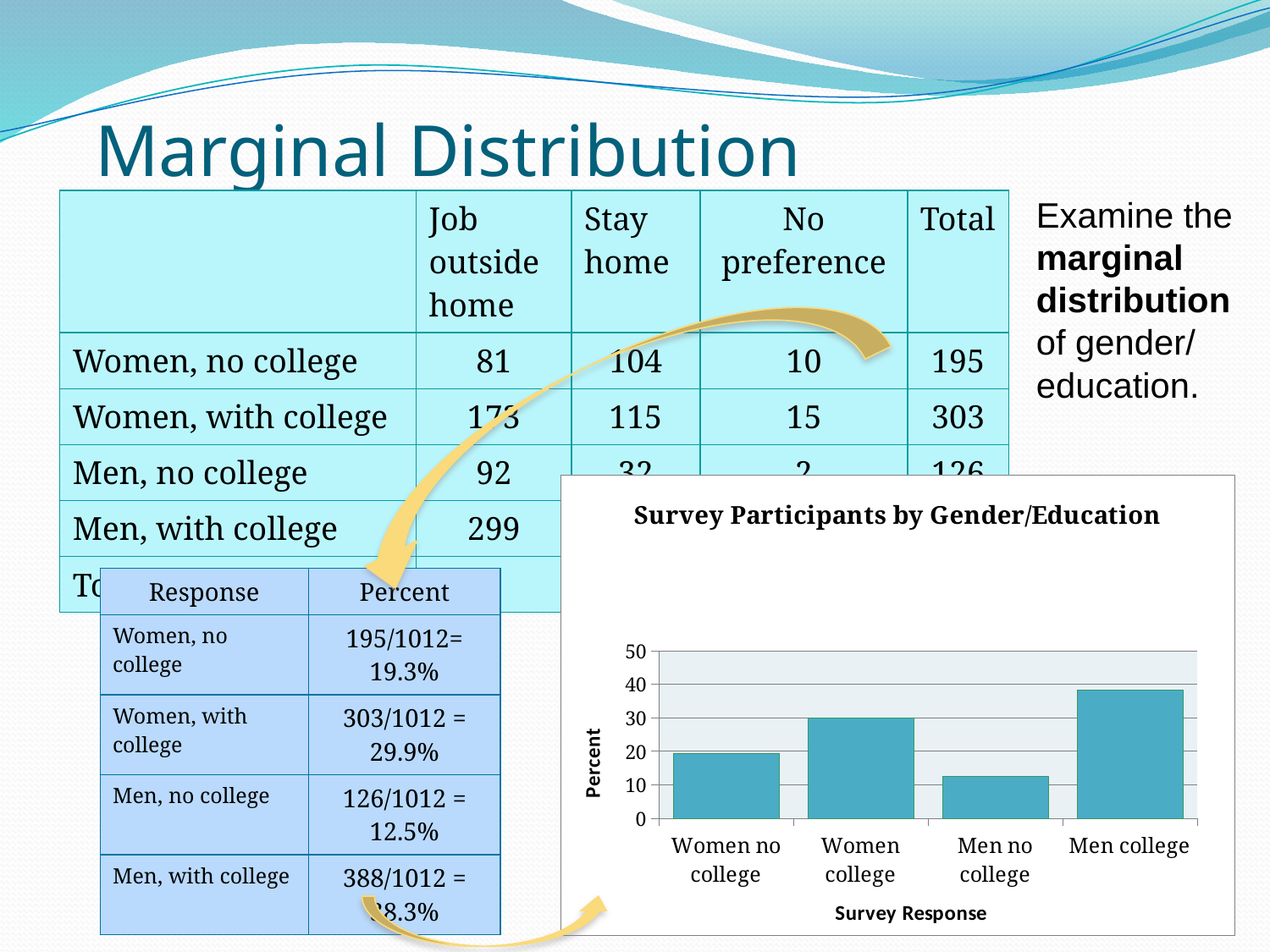
What is the title of the chart? Survey Participants by Gender/Education Is the value for Women no college greater or less than 10? greater How many categories are shown on the x axis of the chart? 4 Is the value for Men college greater or less than 30? greater What kind of chart is shown on the slide? bar chart Which is larger in the chart, the value for Men college or the value for Men no college? Men college Is the value for Men no college greater or less than 20? less Which category has the highest bar in the chart? Men college Which is larger in the chart, the value for Women college or the value for Women no college? Women college What is the label on the vertical axis of the chart? Percent Which category has the lowest bar in the chart? Men no college